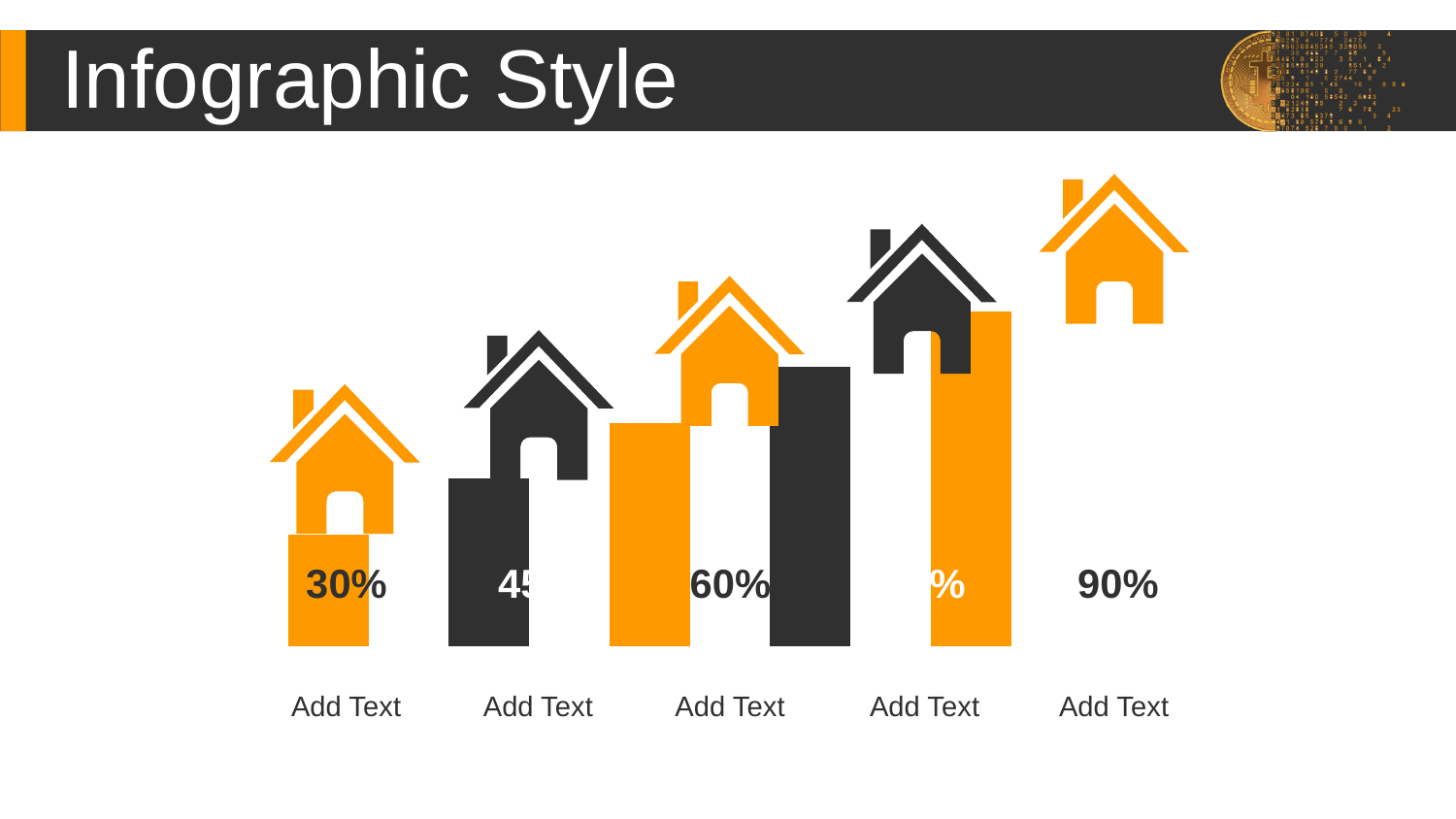
Which is larger, the value of the first bar or the value of the third bar? the third bar What is the title of the slide? Infographic Style What is the value shown for the first (leftmost) bar? 30% Which bar has the lowest value? the first (leftmost) bar, 30% What kind of chart is shown on the slide? bar chart What is the value shown for the third bar? 60% How many bars (categories) does the chart have? 5 What is the difference between the fifth bar's value and the first bar's value? 60% What is the value shown for the fifth (rightmost) bar? 90% Do the bar values rise or fall from left to right? rise Which bar has the highest value? the fifth (rightmost) bar, 90% What is the difference between the third bar's value and the first bar's value? 30%